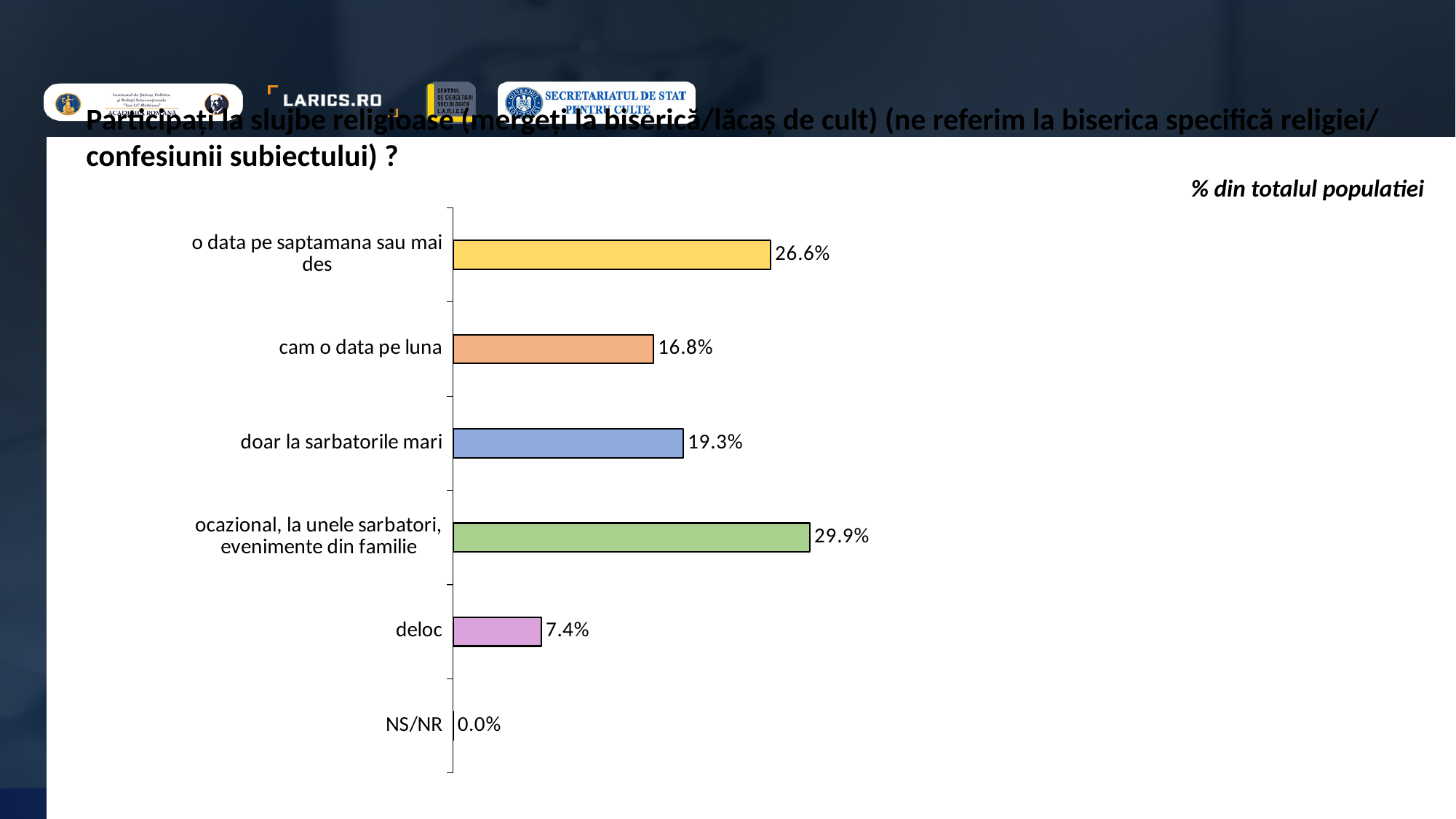
What is the value for "NS/NR"? 0.0% What is the value for "cam o data pe luna"? 16.8% What is the difference between the values for "ocazional, la unele sarbatori, evenimente din familie" and "o data pe saptamana sau mai des"? 3.3% What colour is the bar for "deloc"? purple Which category has the lowest value? NS/NR What is the value for "deloc"? 7.4% What is the value for "o data pe saptamana sau mai des"? 26.6% Which category has the highest value? ocazional, la unele sarbatori, evenimente din familie What is the value for "doar la sarbatorile mari"? 19.3% Which is larger, the value for "doar la sarbatorile mari" or the value for "cam o data pe luna"? doar la sarbatorile mari How many categories are shown in the chart? 6 What kind of chart is shown on the slide? bar chart